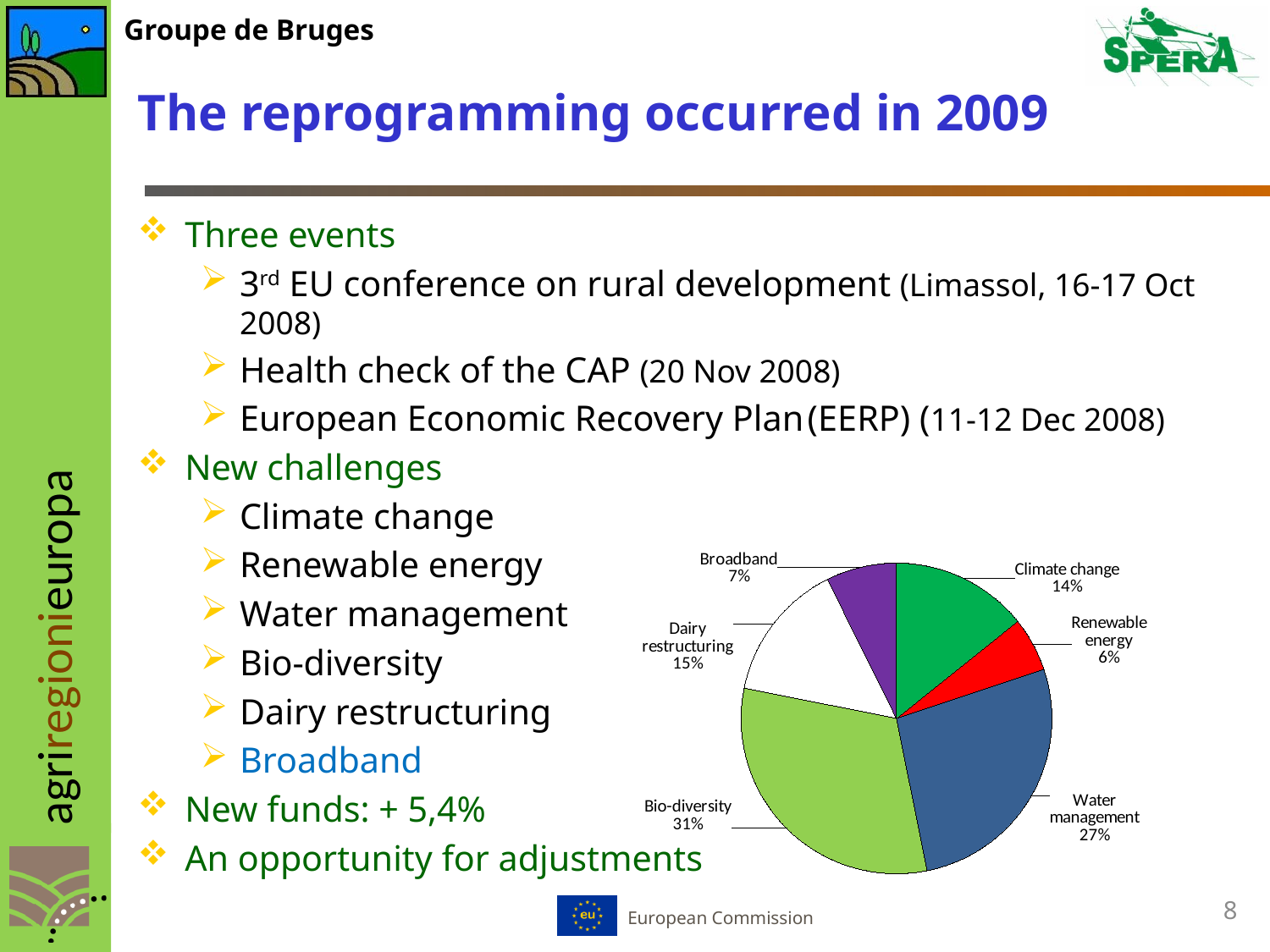
Which category has the largest slice of the pie? Bio-diversity What is the difference in percentage points between Bio-diversity and Water management? 4 Which category has the smallest slice of the pie? Renewable energy What percentage is shown for Water management in the pie chart? 27% What share of the pie does Bio-diversity account for? 31% What type of chart is shown on the slide? Pie chart What percentage is shown for Broadband? 7% What is the difference in percentage points between Climate change and Renewable energy? 8 Which is larger, the share for Dairy restructuring or the share for Climate change? Dairy restructuring What colour is the Broadband slice of the pie? Purple How many categories are shown in the pie chart? 6 What percentage is shown for Dairy restructuring? 15%